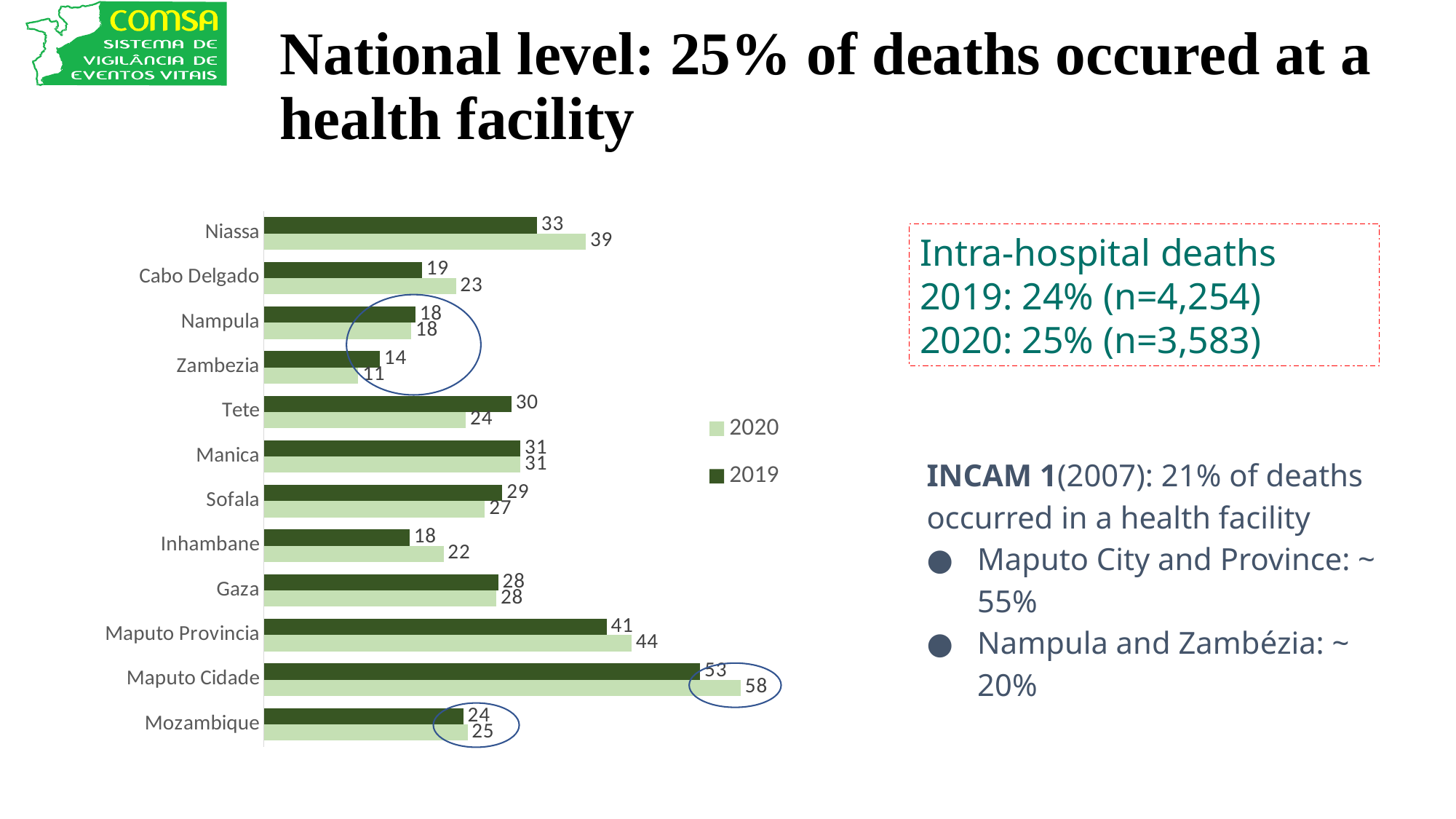
How many series does the legend list? 2 Which category has the highest 2020 value? Maputo Cidade What kind of chart is shown on the slide? Bar chart Which series is shown in dark green in the legend? 2019 Which category has the lowest 2019 value? Zambezia Which is larger for Cabo Delgado, the 2019 value or the 2020 value? 2020 What is the 2019 value for Maputo Cidade? 53 What is the 2019 value for Mozambique? 24 What is the 2020 value for Zambezia? 11 What is the 2020 value for Niassa? 39 How many categories are shown on the chart? 12 What is the difference between the 2020 and 2019 values for Tete? 6